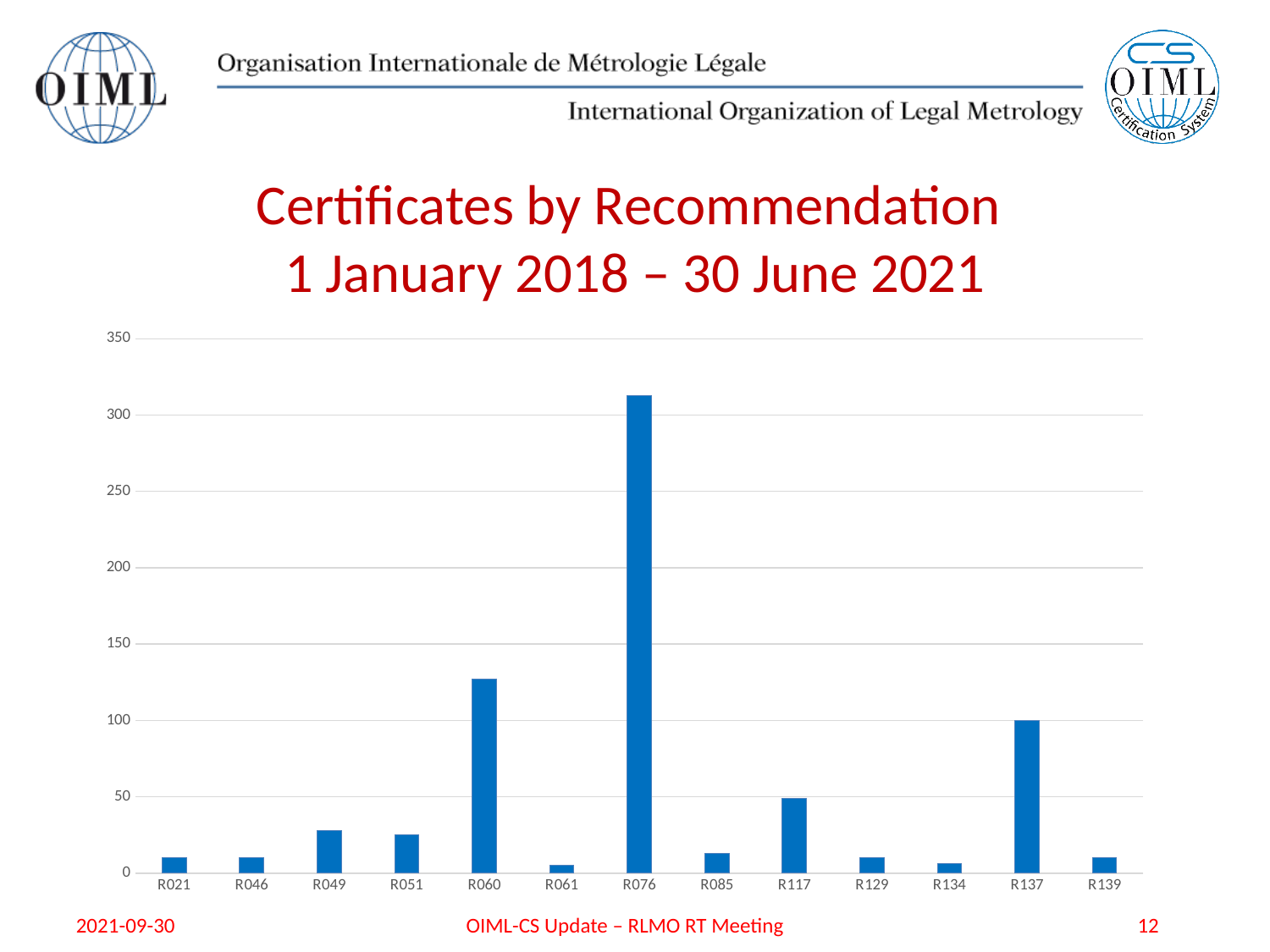
How many Recommendations (categories) are shown on the x axis? 13 What kind of chart is shown on the slide? bar chart What is the title of the chart on the slide? Certificates by Recommendation 1 January 2018 – 30 June 2021 Which Recommendation has the second-highest number of certificates? R060 Is the value for R076 greater or less than 300? greater Is the value for R137 greater or less than 150? less Is the value for R049 greater or less than 50? less Which Recommendation has the highest number of certificates? R076 Which has more certificates, R117 or R085? R117 Which has more certificates, R060 or R137? R060